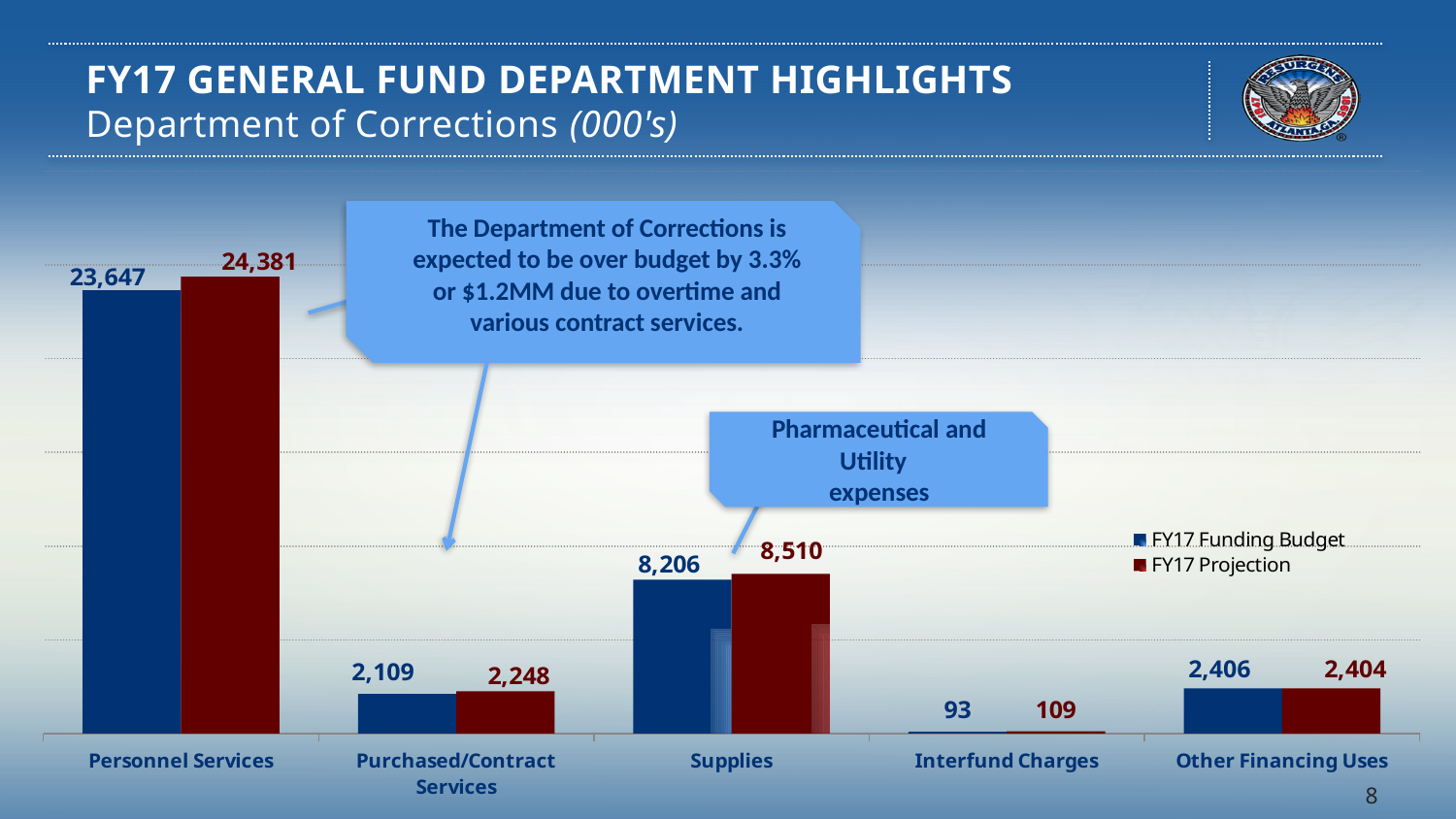
What is the difference between the FY17 Projection and the FY17 Funding Budget for Personnel Services? 734 What is the FY17 Projection value for Supplies? 8,510 How many categories are shown on the x axis of the chart? 5 How many series does the chart legend list? 2 Which category has the highest FY17 Projection value? Personnel Services What is the FY17 Funding Budget value for Other Financing Uses? 2,406 What kind of chart is shown on the slide? Bar chart Which is larger for Supplies, the FY17 Funding Budget or the FY17 Projection? FY17 Projection What is the difference between the FY17 Projection and the FY17 Funding Budget for Purchased/Contract Services? 139 Which category has the lowest FY17 Funding Budget value? Interfund Charges What is the FY17 Funding Budget value for Personnel Services? 23,647 What is the FY17 Projection value for Interfund Charges? 109